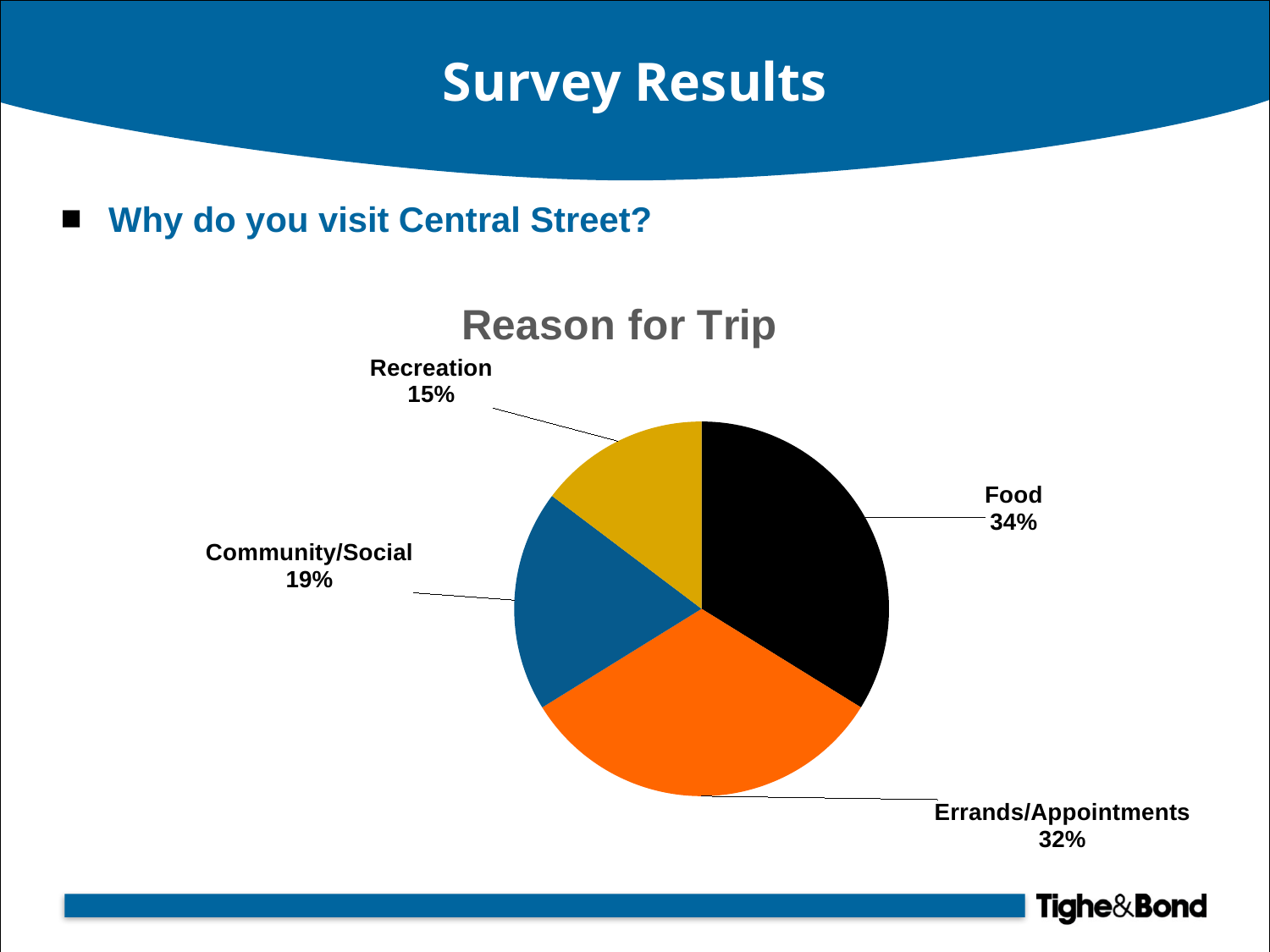
What share of trips is for Community/Social? 19% What share of trips is for Recreation? 15% How many slices does the pie chart have? 4 What type of chart is shown on the slide? pie chart What colour is the Errands/Appointments slice? orange Which is larger, the share for Community/Social or the share for Recreation? Community/Social What is the difference in percentage points between Food and Recreation? 19 What share of trips is for Food? 34% What share of trips is for Errands/Appointments? 32% What is the title of the chart? Reason for Trip Which reason for trip has the largest share? Food Which reason for trip has the smallest share? Recreation